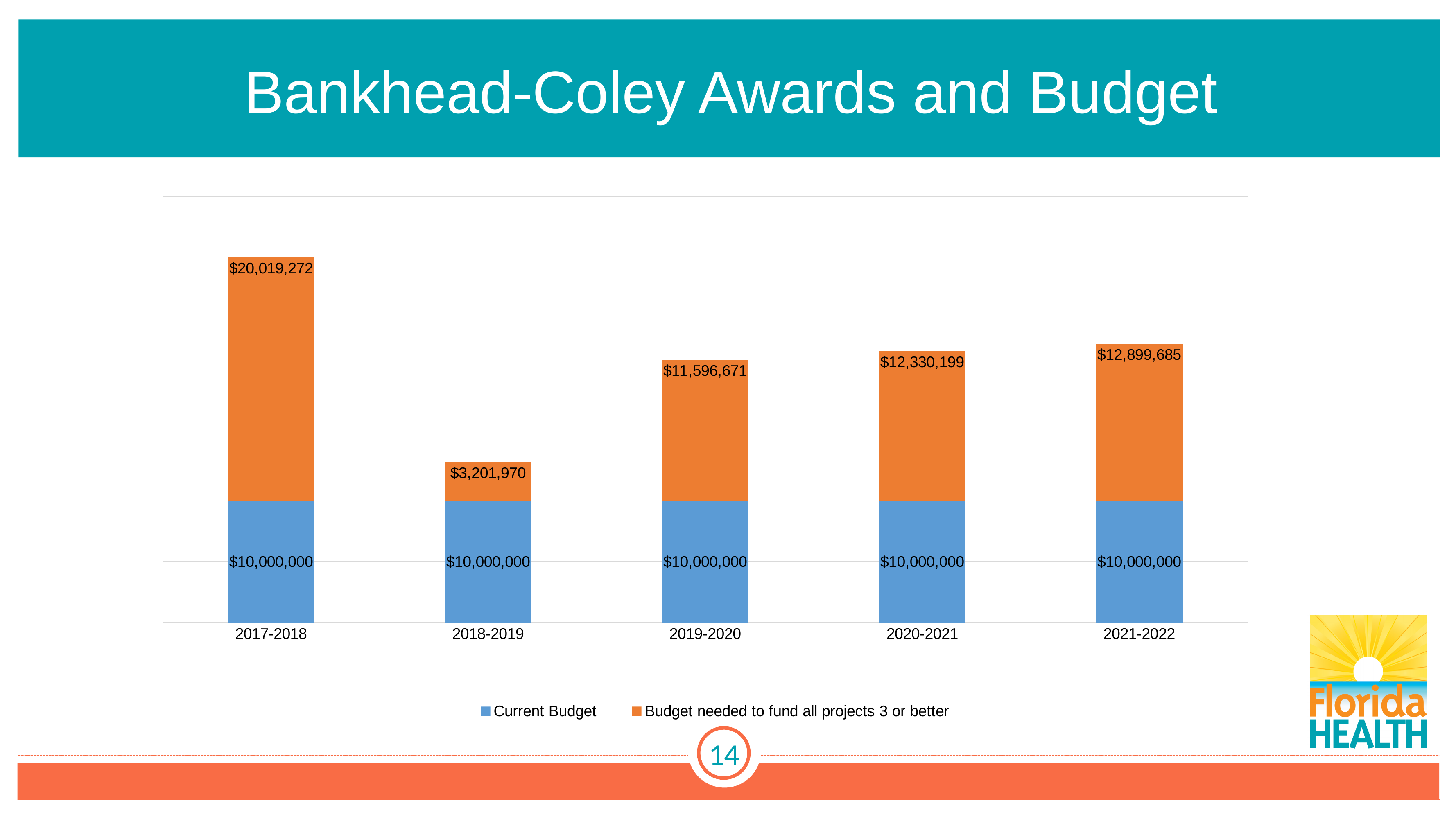
How many fiscal years are shown on the x axis? 5 How many series does the legend list? 2 What is the value of 'Budget needed to fund all projects 3 or better' for 2021-2022? $12,899,685 What kind of chart is shown on the slide? Stacked bar chart What is the value of 'Budget needed to fund all projects 3 or better' for 2018-2019? $3,201,970 What is the value of 'Budget needed to fund all projects 3 or better' for 2017-2018? $20,019,272 Which year has the lowest 'Budget needed to fund all projects 3 or better'? 2018-2019 What is the difference between the 'Budget needed to fund all projects 3 or better' values for 2017-2018 and 2018-2019? $16,817,302 Is the 'Budget needed to fund all projects 3 or better' larger in 2019-2020 or 2020-2021? 2020-2021 Which year has the highest 'Budget needed to fund all projects 3 or better'? 2017-2018 What is the total height of the stacked bar for 2019-2020? $21,596,671 What is the Current Budget value for 2020-2021? $10,000,000